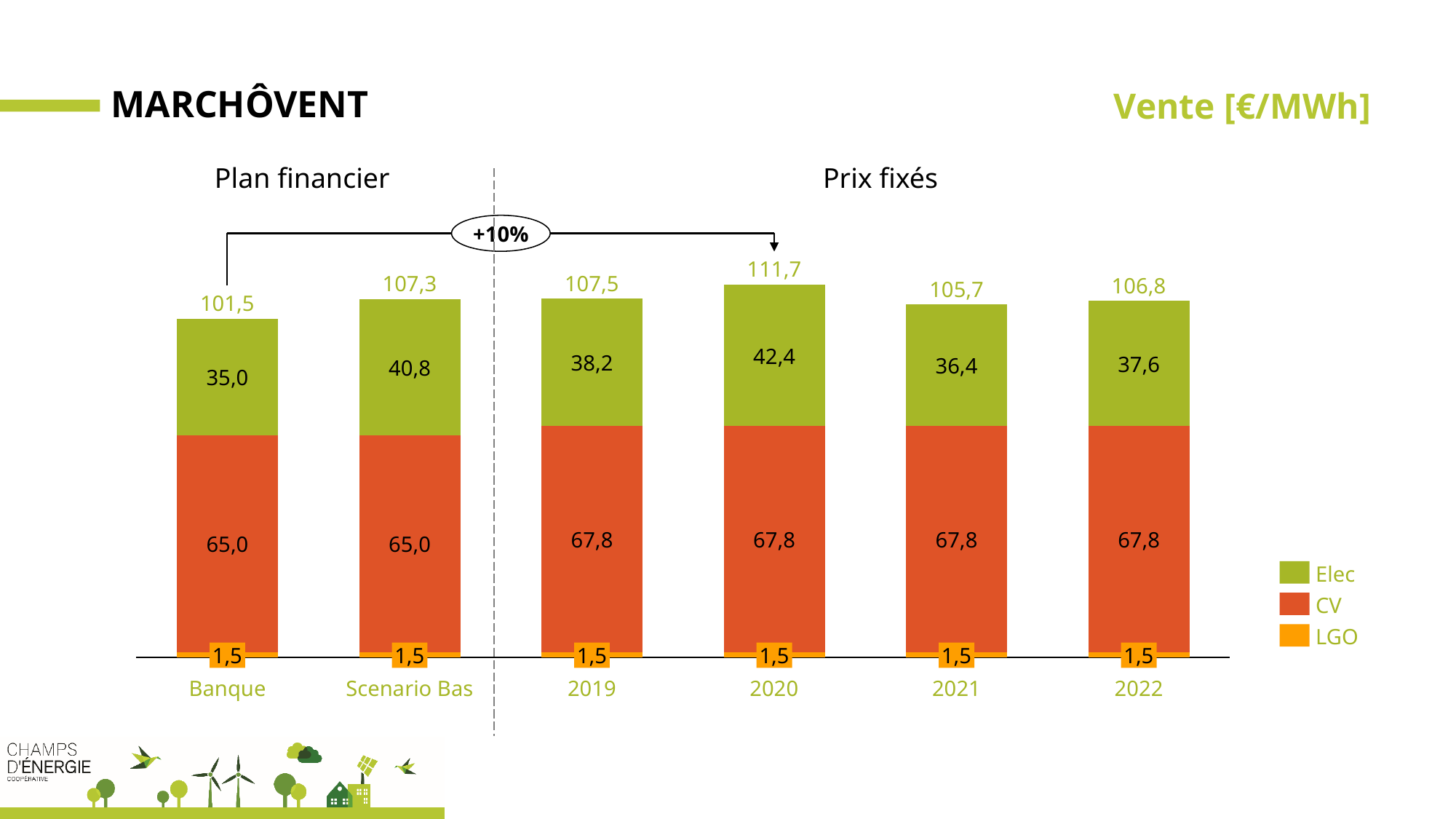
What is the difference between the Elec values for 2020 and 2021? 6,0 What is the Elec value for 2020? 42,4 How many series does the legend list? 3 How many categories are shown on the x axis? 6 Which is larger, the Elec value for 2019 or the Elec value for 2022? 2019 What is the CV value for Banque? 65,0 What is the title shown at the top right of the chart? Vente [€/MWh] What is the total of the stacked bar for Scenario Bas? 107,3 Which category has the lowest total? Banque Which category has the highest total? 2020 What kind of chart is shown? Stacked bar chart What is the LGO value for 2022? 1,5